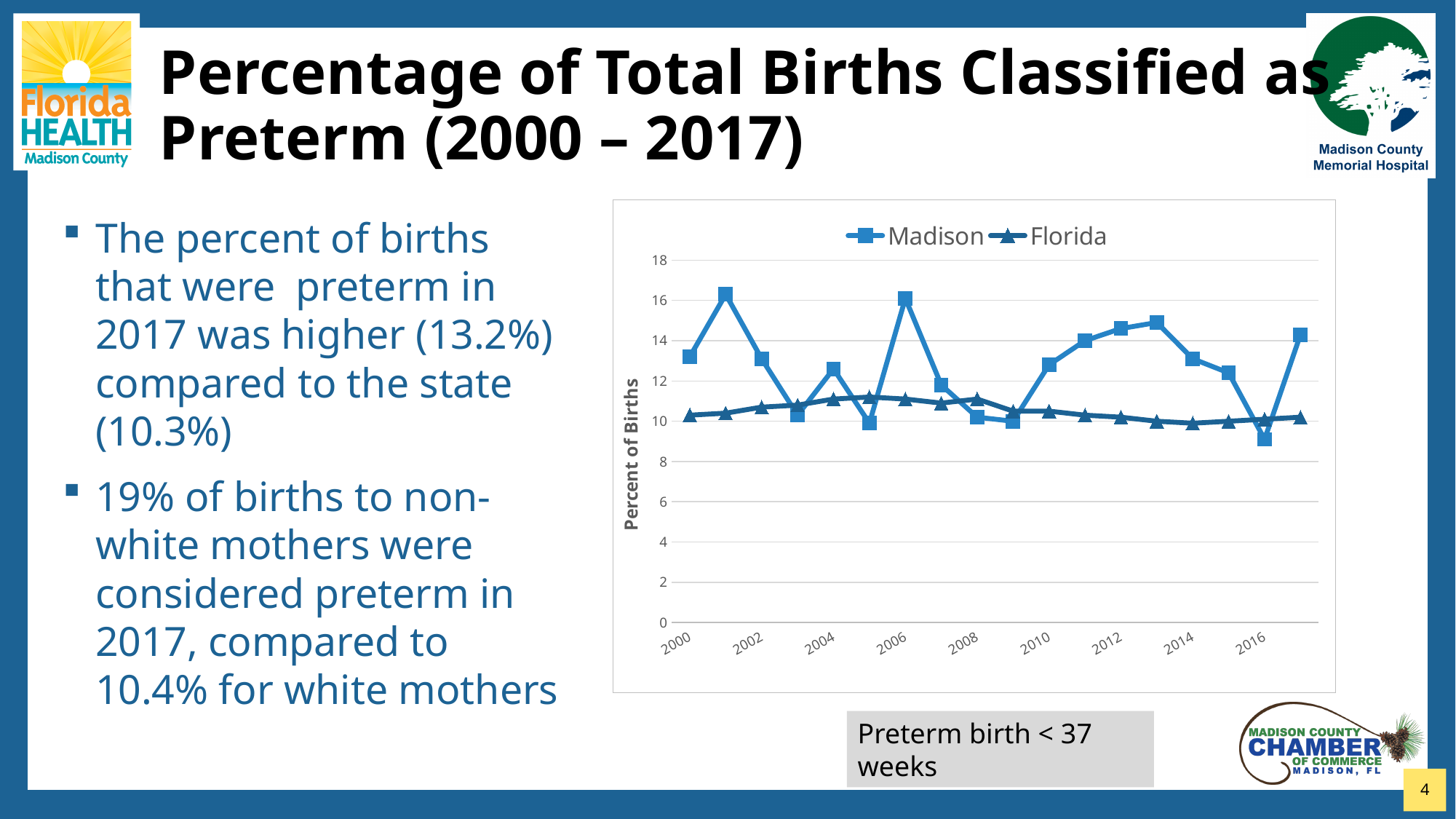
Is the Florida value for 2004 greater or less than 12? less What is the label on the vertical axis of the chart? Percent of Births In 2001, which series has the higher value, Madison or Florida? Madison Is the Madison value for 2001 greater or less than 14? greater Does the Madison series rise or fall from 2010 to 2013? Rise Which two series are shown in the chart legend? Madison and Florida In which year does the Madison series reach its lowest value? 2016 How many series does the chart legend list? 2 In 2016, which series has the higher value, Madison or Florida? Florida Is the Madison value for 2013 greater or less than 14? greater What kind of chart is shown on the slide? Line chart